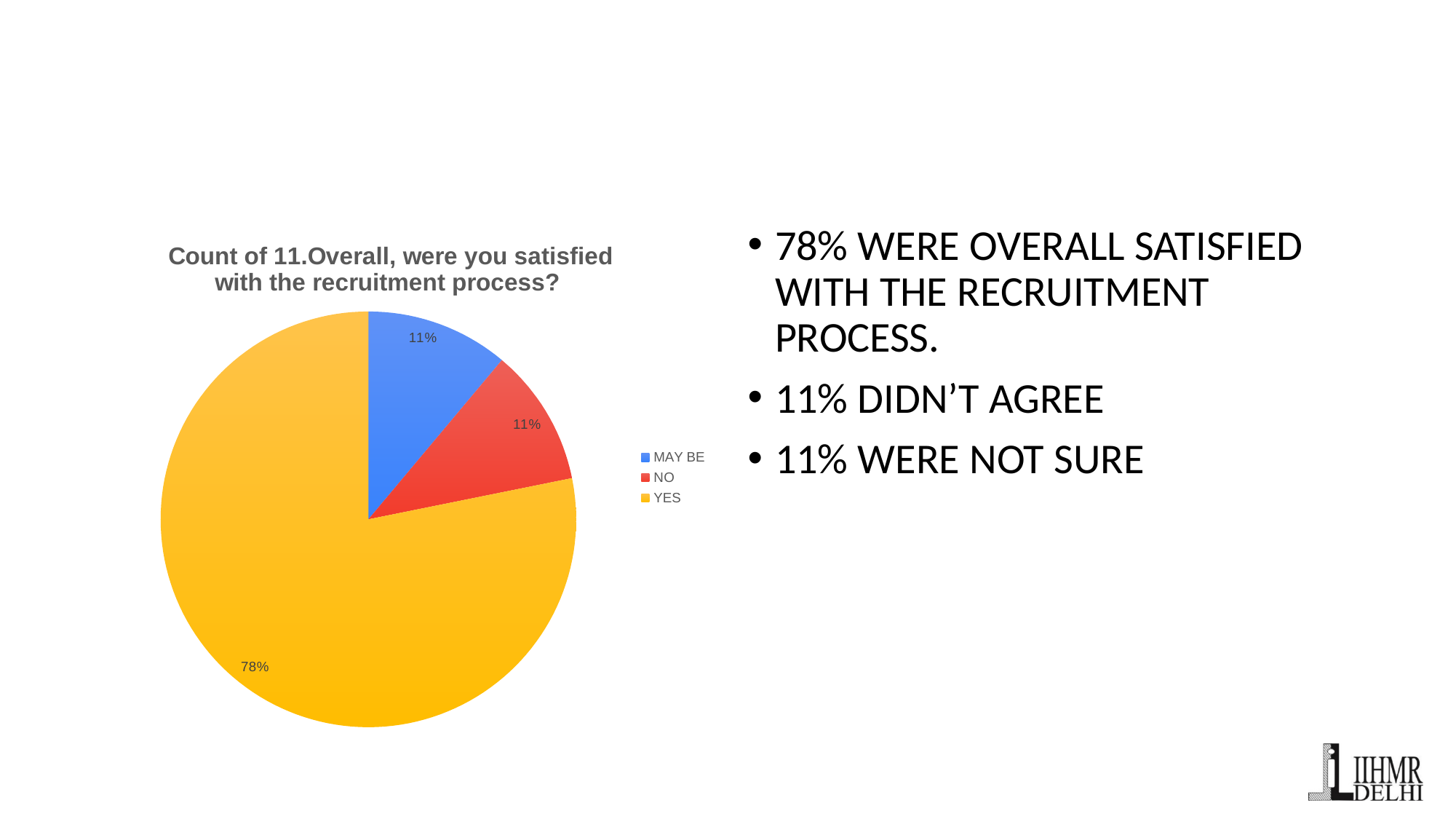
What is the difference between the YES share and the NO share? 67% Which is larger, the YES slice or the MAY BE slice? YES What colour is the YES slice in the pie chart? yellow Which category has the largest slice of the pie? YES How many entries does the legend list? 3 How many slices does the pie chart have? 3 What type of chart is shown on the slide? pie chart What share of the pie does the YES slice represent? 78% What is the title of the pie chart? Count of 11.Overall, were you satisfied with the recruitment process? What share of the pie does the MAY BE slice represent? 11% What share of the pie does the NO slice represent? 11% What is the combined share of the NO and MAY BE slices? 22%